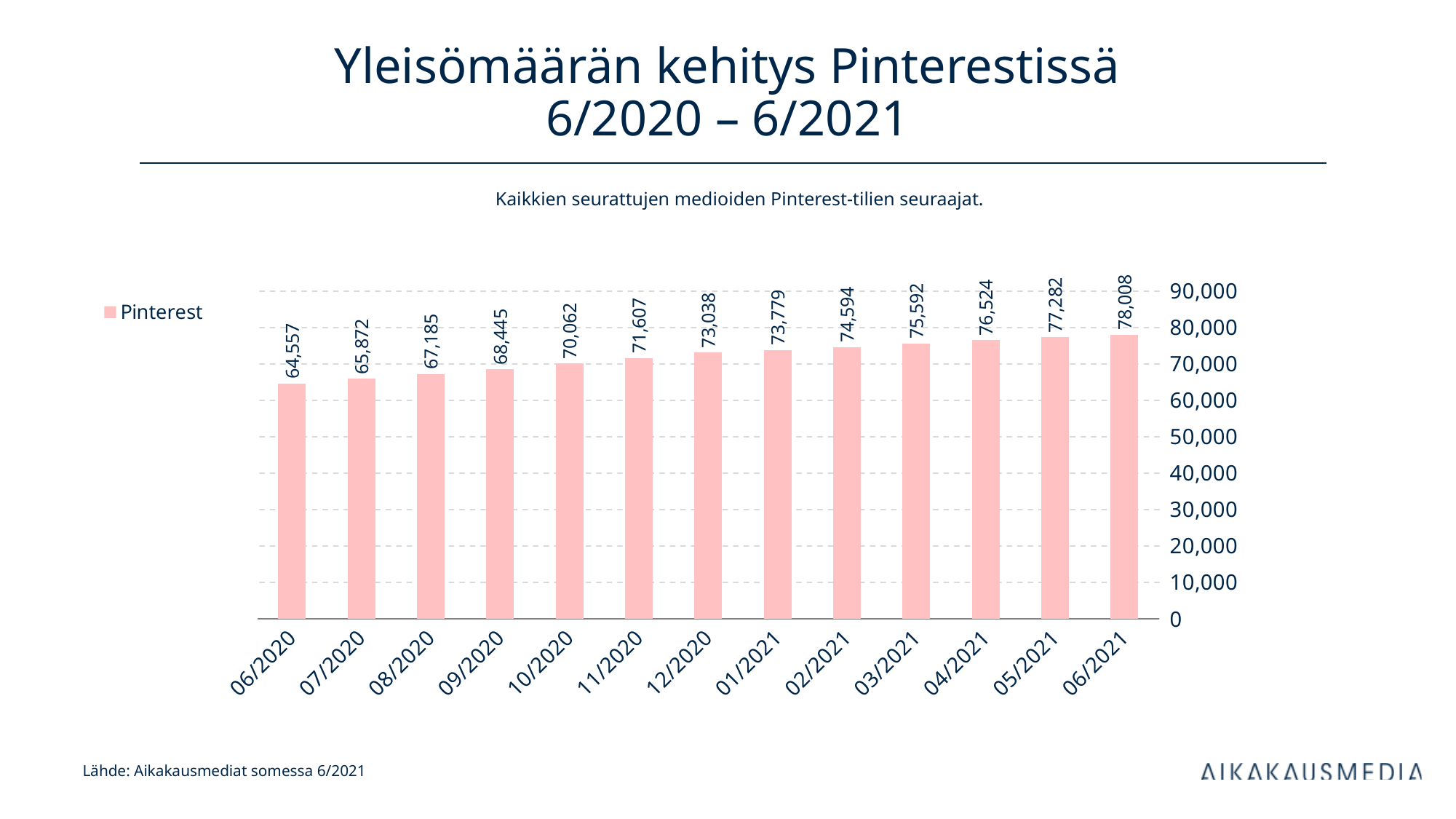
Do the values rise or fall from 06/2020 to 06/2021? rise Which is larger, the value for 03/2021 or the value for 10/2020? 03/2021 Which month has the lowest value? 06/2020 How many series does the legend list? 1 What is the value for 06/2020? 64,557 What is the value for 12/2020? 73,038 What is the difference between the values for 06/2021 and 06/2020? 13,451 How many months are shown on the x axis? 13 What kind of chart is shown? bar chart Is the value for 09/2020 greater or less than 70,000? less Which month has the highest value? 06/2021 What is the value for 06/2021? 78,008